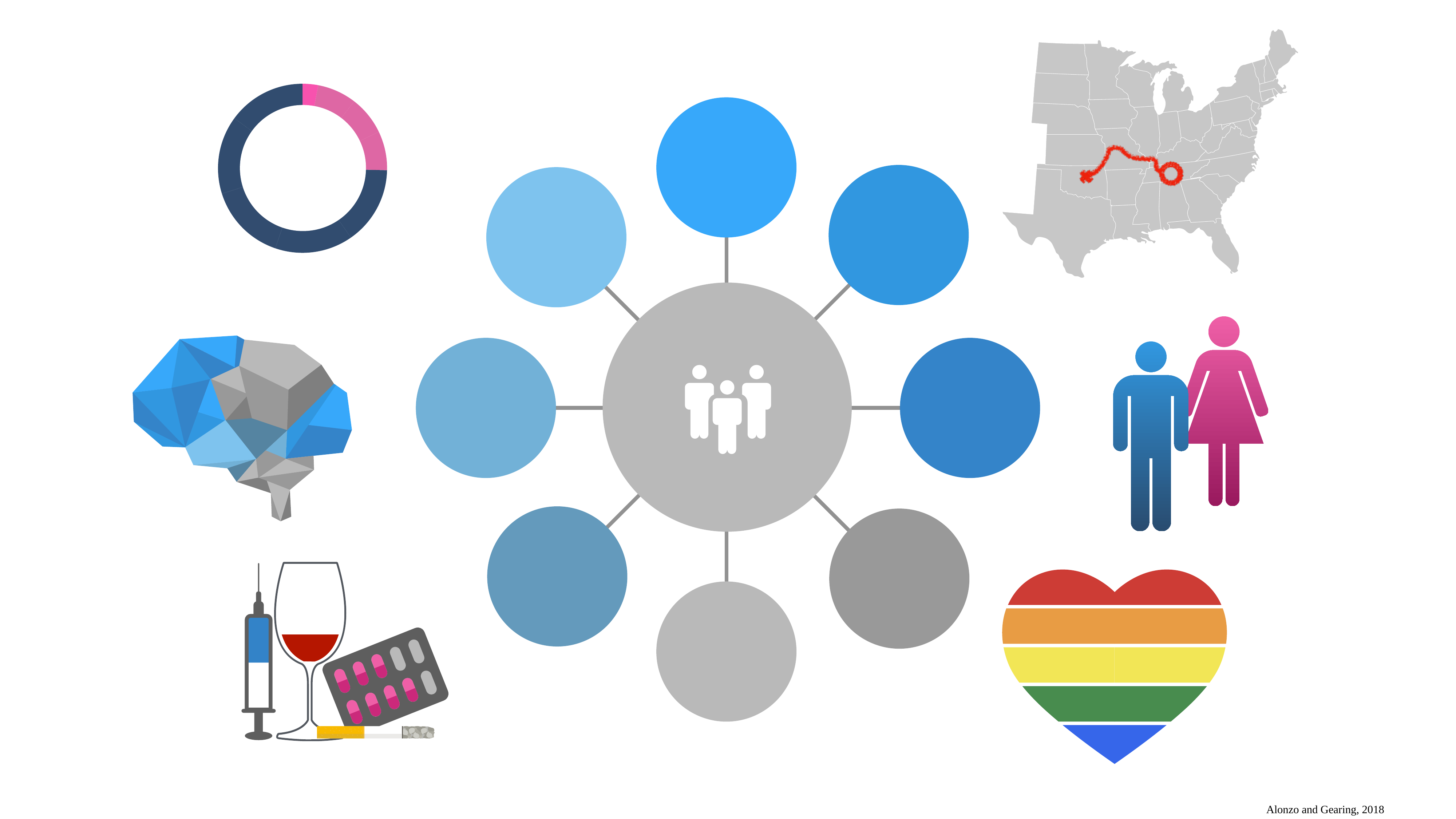
What two colours are used for the slices of the doughnut chart in the top-left corner? Dark blue and pink What kind of chart is shown in the top-left corner of the slide? Doughnut (pie) chart In the doughnut chart in the top-left corner, which slice is larger, the dark blue one or the pink one? The dark blue one In the doughnut chart in the top-left corner, which slice is the smallest? The pink slice Does the doughnut chart in the top-left corner show any data labels or a legend? No